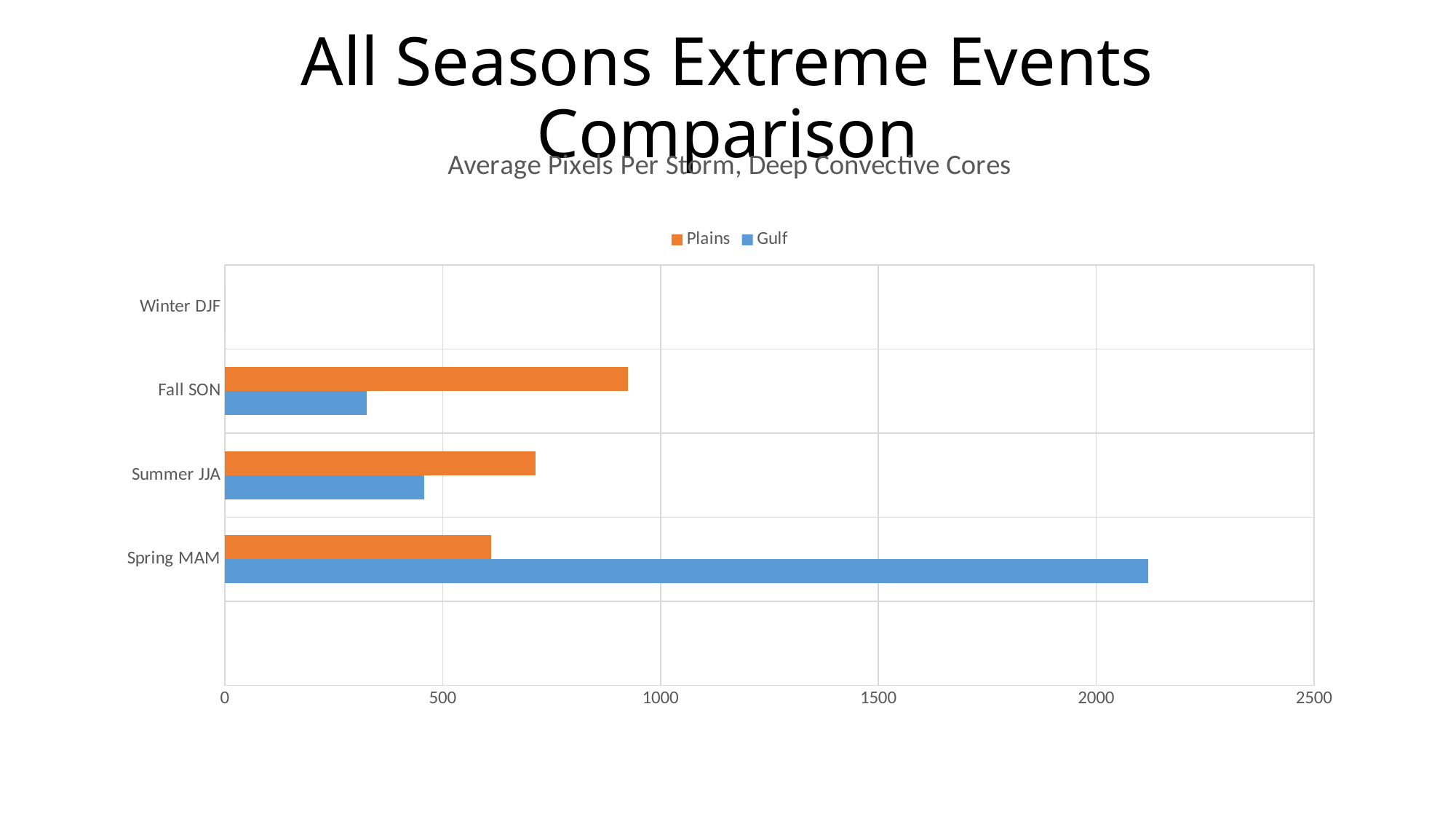
Which season has the highest Gulf value? Spring MAM Is the Plains value for Fall SON greater or less than 1000? less For Spring MAM, which is larger, the Plains value or the Gulf value? Gulf Which season has the highest Plains value? Fall SON How many series does the legend list? 2 Among the seasons with visible bars, which has the lowest Gulf value? Fall SON What kind of chart is shown on the slide? bar chart For Fall SON, which is larger, the Plains value or the Gulf value? Plains Is the Gulf value for Spring MAM greater or less than 2000? greater Is the Gulf value for Summer JJA greater or less than 500? less What is the chart's subtitle shown below the main title? Average Pixels Per Storm, Deep Convective Cores How many season categories are shown on the vertical axis? 4